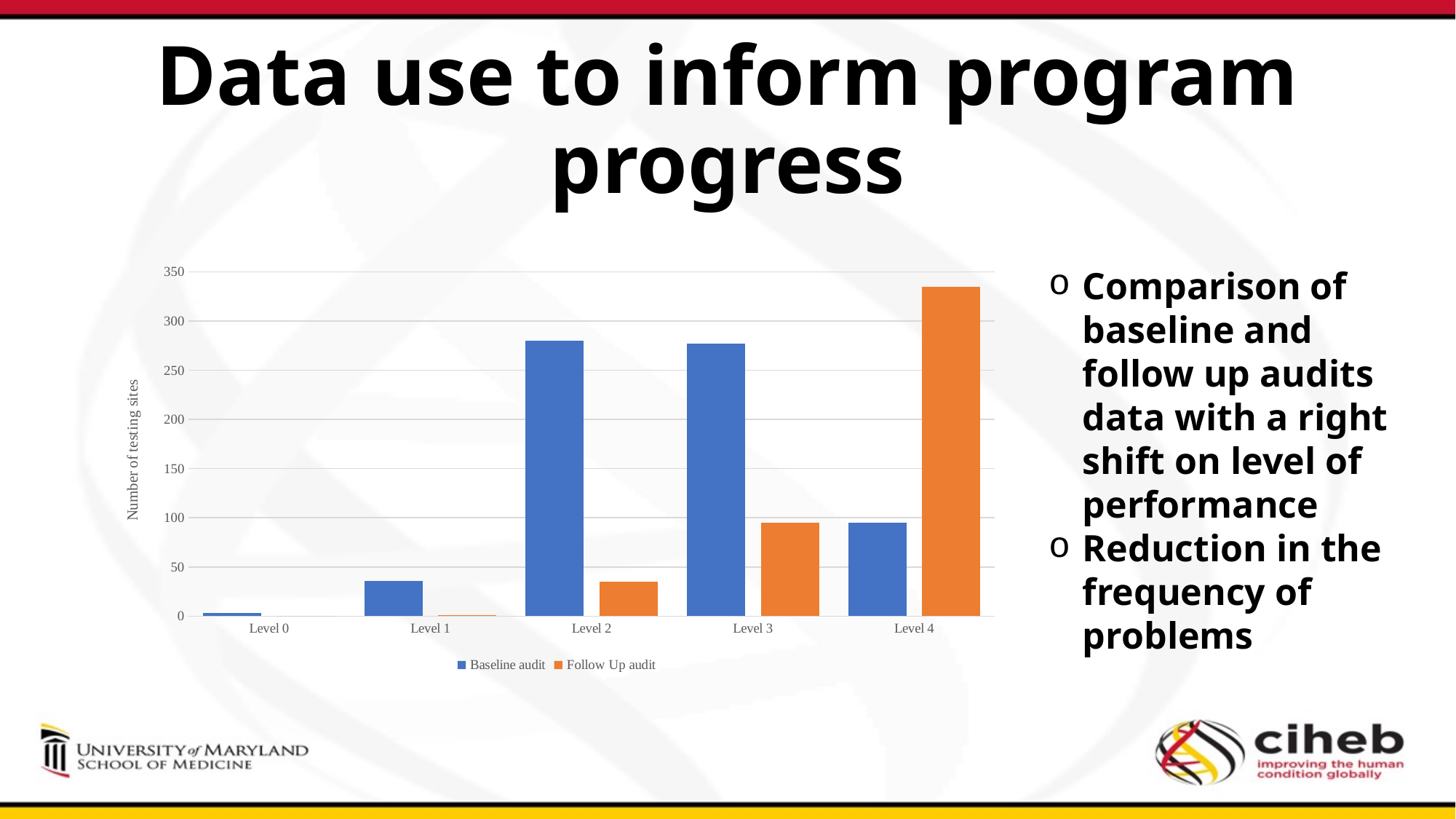
What is the label on the chart's vertical axis? Number of testing sites Is the Follow Up audit value for Level 4 greater or less than 300? greater Is the Baseline audit value for Level 1 greater or less than 50? less At Level 4, which series has the larger value, Baseline audit or Follow Up audit? Follow Up audit At Level 2, which series has the larger value, Baseline audit or Follow Up audit? Baseline audit Which level has the highest Follow Up audit value? Level 4 Which level has the lowest Baseline audit value? Level 0 Is the Baseline audit value for Level 2 greater or less than 250? greater How many level categories are shown on the x axis of the chart? 5 What kind of chart is shown on the slide? bar chart How many series does the chart's legend list? 2